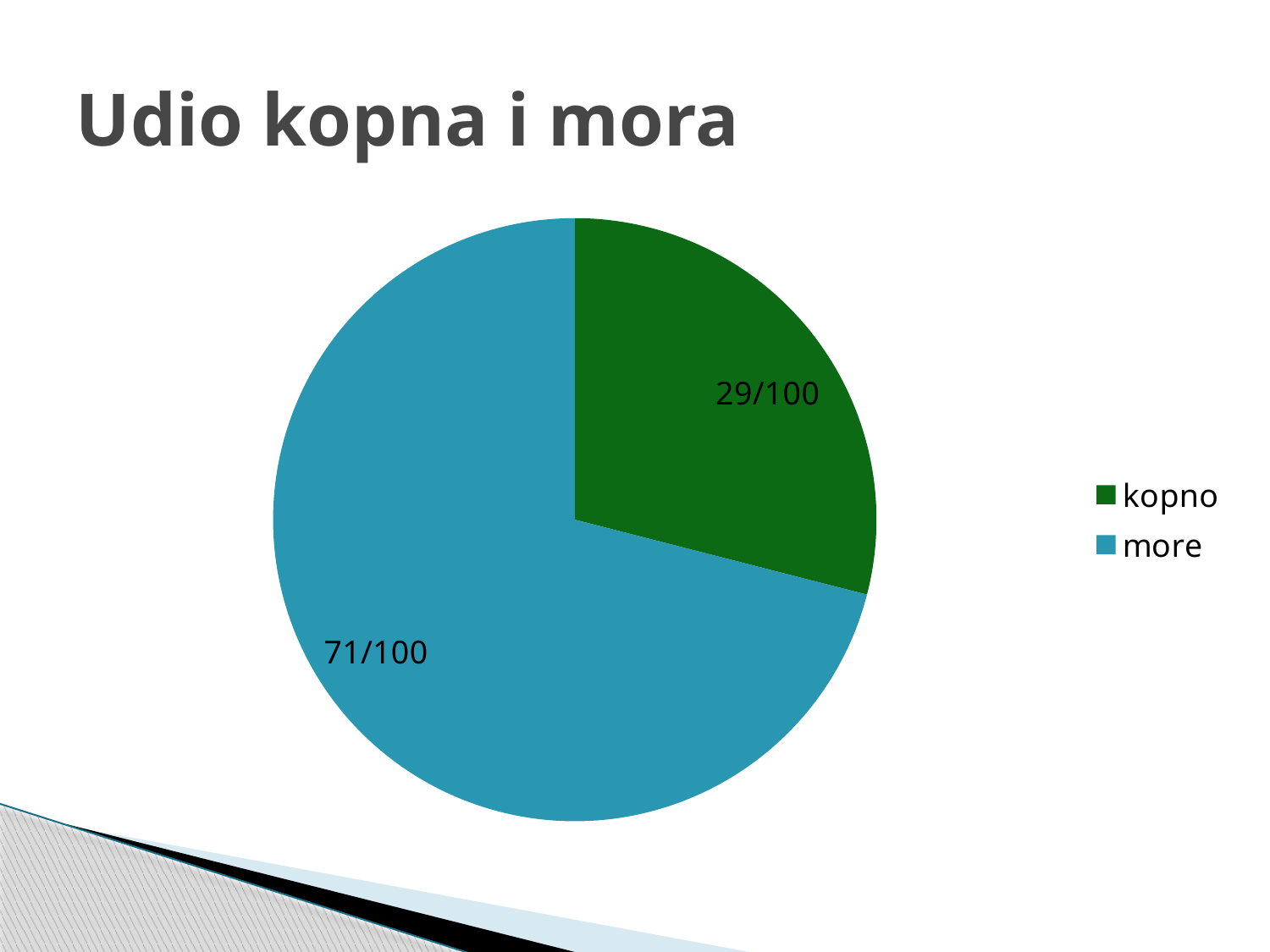
What share of the pie does the kopno slice represent? 29/100 Which slice is the smallest? kopno Which slice is the largest? more What kind of chart is shown on the slide? pie chart What colour is the slice for more? blue How many entries does the legend list? 2 What is the value shown for kopno? 29/100 How many slices does the pie chart have? 2 What is the title of the slide? Udio kopna i mora Which is larger, kopno or more? more What is the value shown for more? 71/100